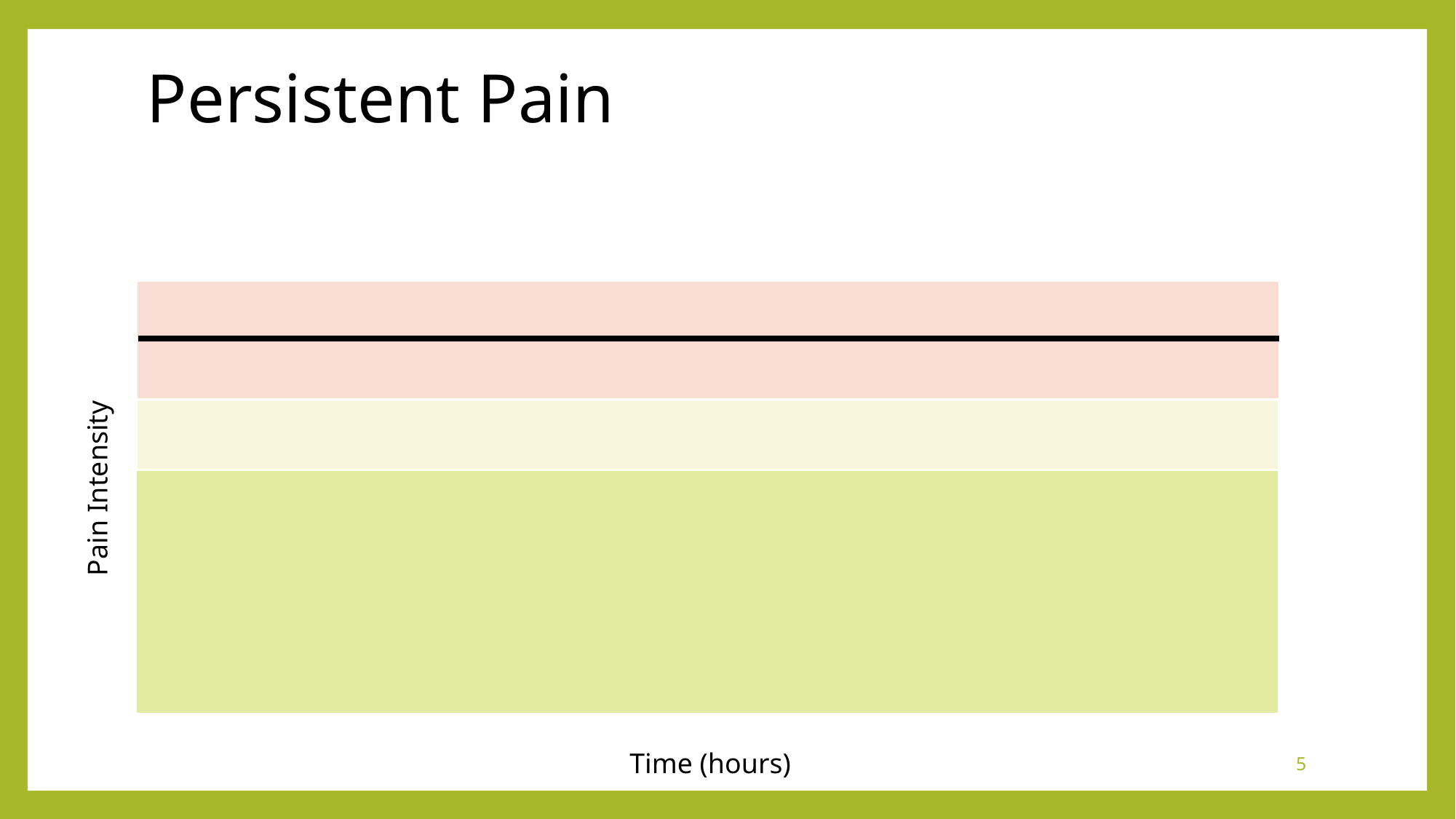
What is the label of the y axis? Pain Intensity What kind of chart is shown on the slide? line chart What is the label of the x axis? Time (hours) Does the plotted line rise, fall, or stay flat as time increases along the x axis? stays flat